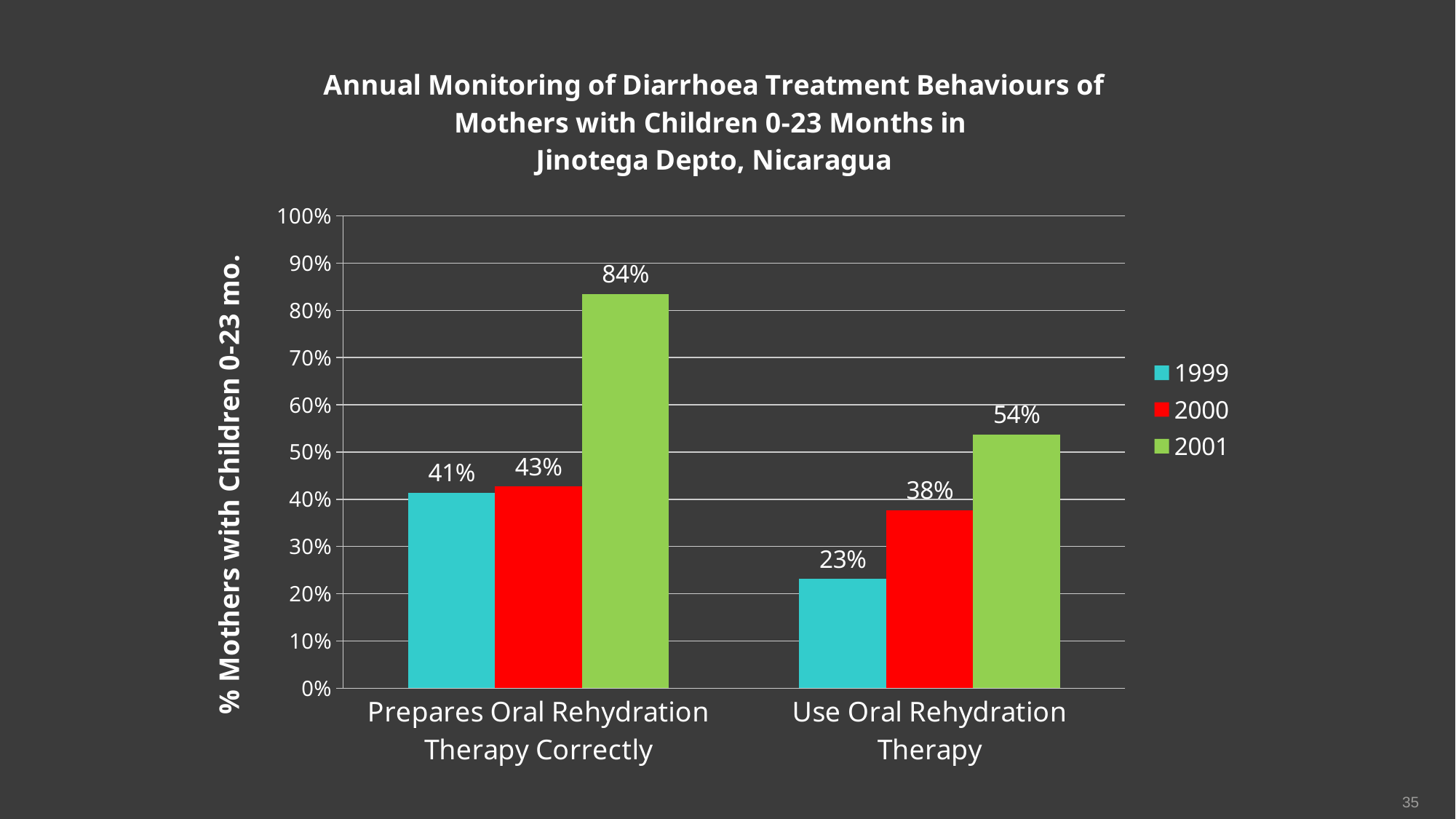
What is the difference between the 2001 and 1999 values for 'Prepares Oral Rehydration Therapy Correctly'? 43% Which year has the highest value in the 'Use Oral Rehydration Therapy' category? 2001 How many categories are shown on the x axis? 2 What is the value for 1999 in the 'Use Oral Rehydration Therapy' category? 23% How many series does the legend list? 3 What kind of chart is shown on the slide? Bar chart Which year has the lowest value in the 'Prepares Oral Rehydration Therapy Correctly' category? 1999 Which is larger: the 2000 value for 'Prepares Oral Rehydration Therapy Correctly' or the 2000 value for 'Use Oral Rehydration Therapy'? Prepares Oral Rehydration Therapy Correctly What is the label of the vertical axis? % Mothers with Children 0-23 mo. What is the value for 2001 in the 'Prepares Oral Rehydration Therapy Correctly' category? 84% What is the difference between the 2001 and 2000 values for 'Use Oral Rehydration Therapy'? 16% What is the value for 2000 in the 'Prepares Oral Rehydration Therapy Correctly' category? 43%